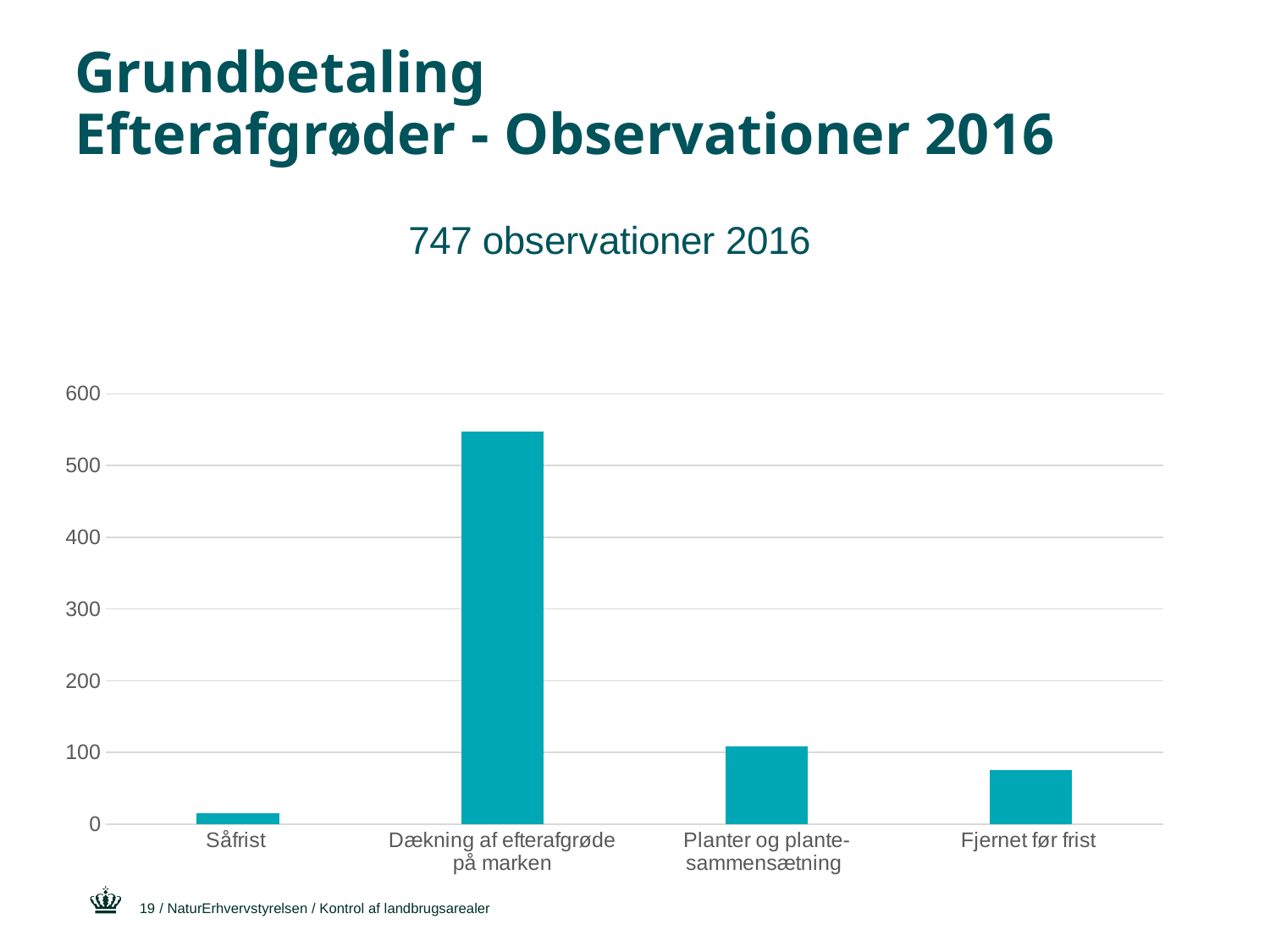
What is the title shown above the chart? 747 observationer 2016 Which is larger: the value for Såfrist or the value for Fjernet før frist? Fjernet før frist Is the value for Planter og plantesammensætning greater or less than 200? less What kind of chart is shown on the slide? Bar chart How many categories are shown on the x axis of the chart? 4 Which category has the highest value in the chart? Dækning af efterafgrøde på marken What is the highest value shown on the y axis of the chart? 600 Is the value for Såfrist greater or less than 100? less Is the value for Fjernet før frist greater or less than 100? less Which is larger: the value for Planter og plantesammensætning or the value for Fjernet før frist? Planter og plantesammensætning Which category has the lowest value in the chart? Såfrist